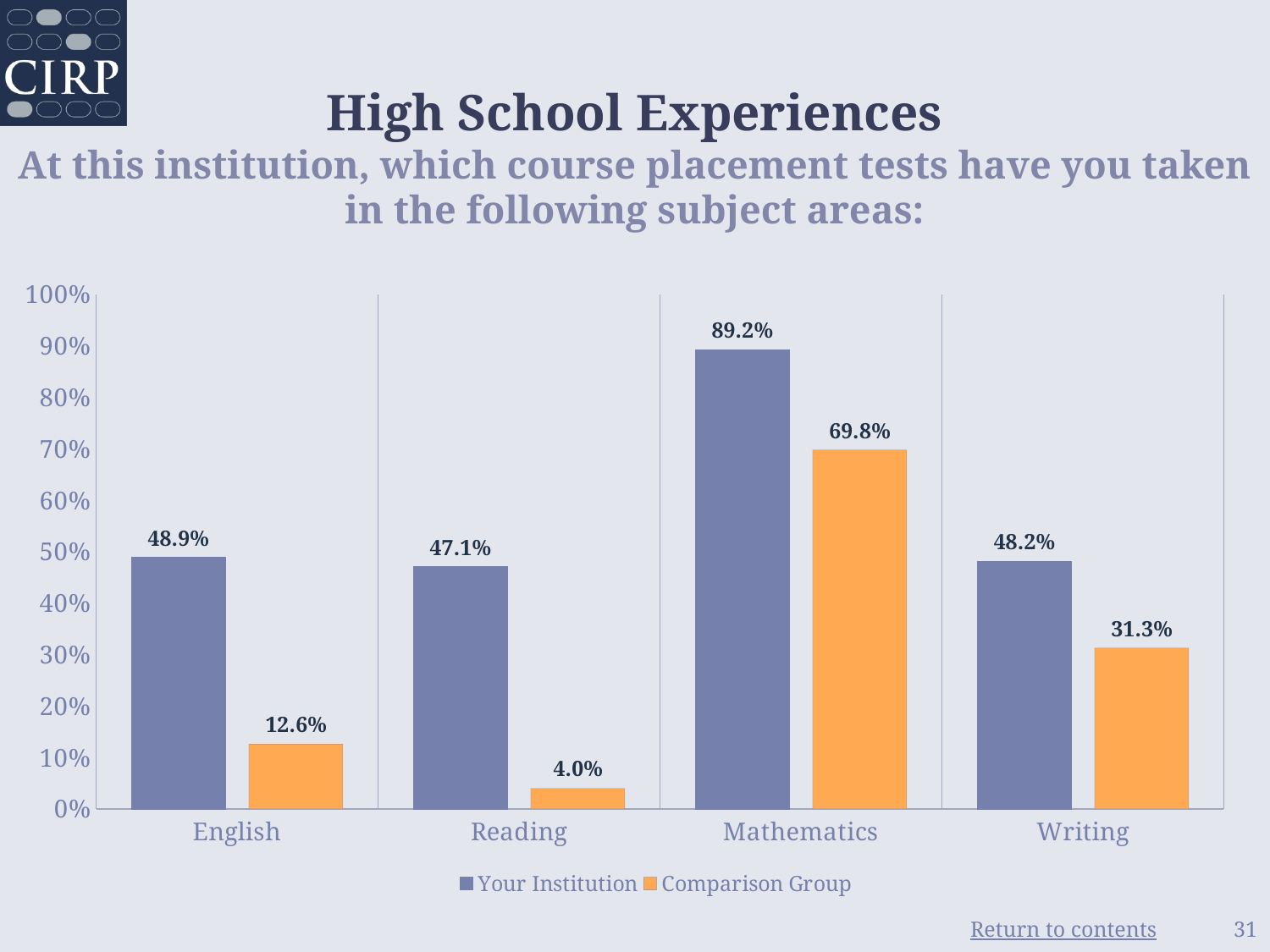
What kind of chart is shown on the slide? Bar chart What is the value for Your Institution in Mathematics? 89.2% How many series does the legend list? 2 What is the difference between Your Institution and the Comparison Group in Mathematics? 19.4% Which subject area has the highest value for Your Institution? Mathematics Is the value for the Comparison Group in Mathematics greater or less than 60%? greater What is the value for the Comparison Group in Reading? 4.0% How many subject areas are shown on the x axis? 4 What is the difference between Your Institution and the Comparison Group in English? 36.3% What is the value for the Comparison Group in Writing? 31.3% Which subject area has the lowest value for the Comparison Group? Reading Which is larger in Writing: Your Institution or the Comparison Group? Your Institution